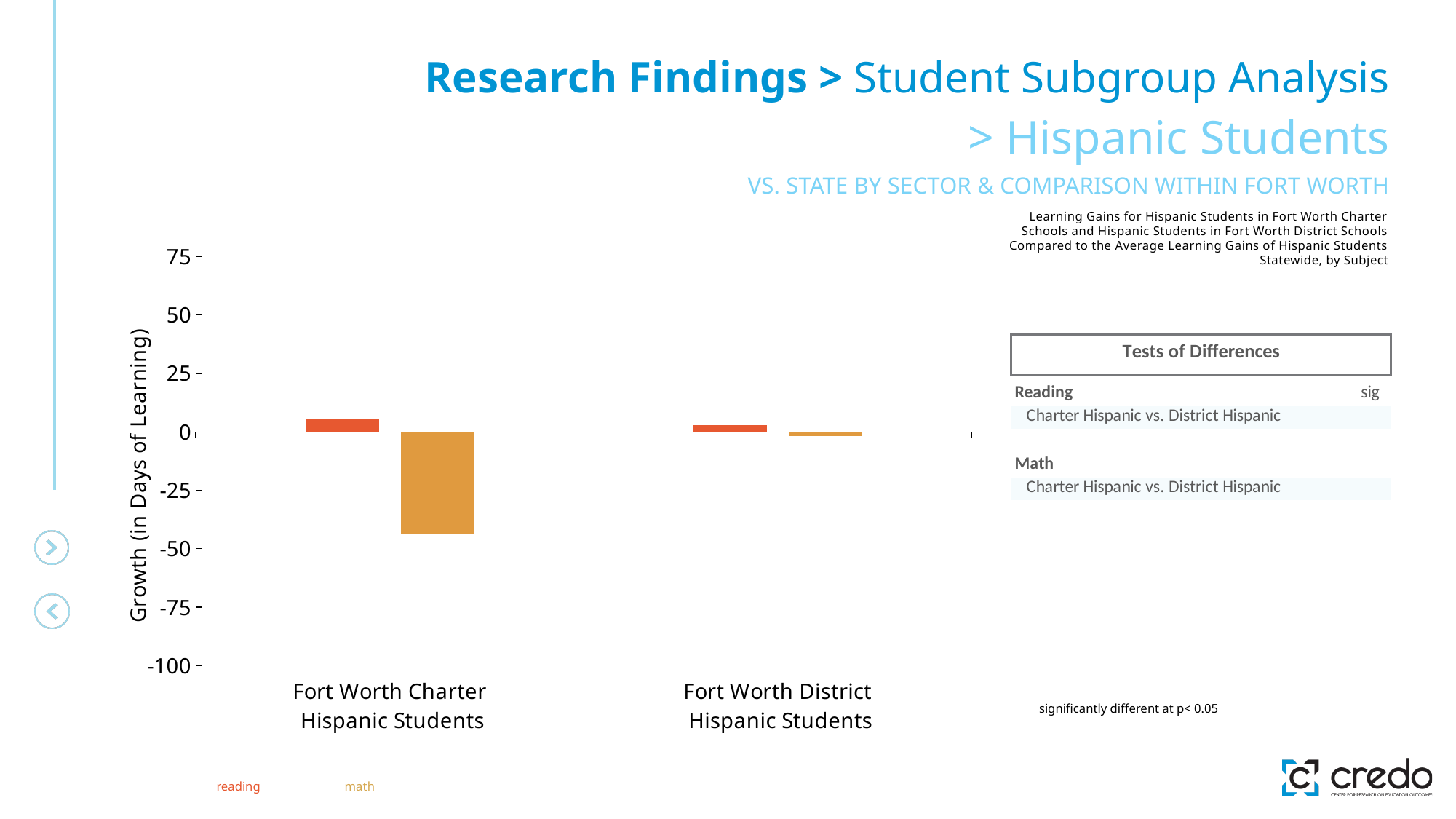
Which colour represents the math series in the chart? orange Is the math value for Fort Worth Charter Hispanic Students greater or less than -50? greater Which is larger, the math value for Fort Worth Charter Hispanic Students or the math value for Fort Worth District Hispanic Students? Fort Worth District Hispanic Students How many series does the chart's legend list? 2 Is the reading value for Fort Worth Charter Hispanic Students greater or less than 25? less Is the math value for Fort Worth Charter Hispanic Students greater or less than -25? less Which is larger for Fort Worth Charter Hispanic Students, the reading value or the math value? reading Which series has the lowest bar in the chart? math for Fort Worth Charter Hispanic Students How many student groups are shown on the x axis of the chart? 2 What kind of chart is shown on the slide? bar chart What is the label on the chart's y axis? Growth (in Days of Learning)